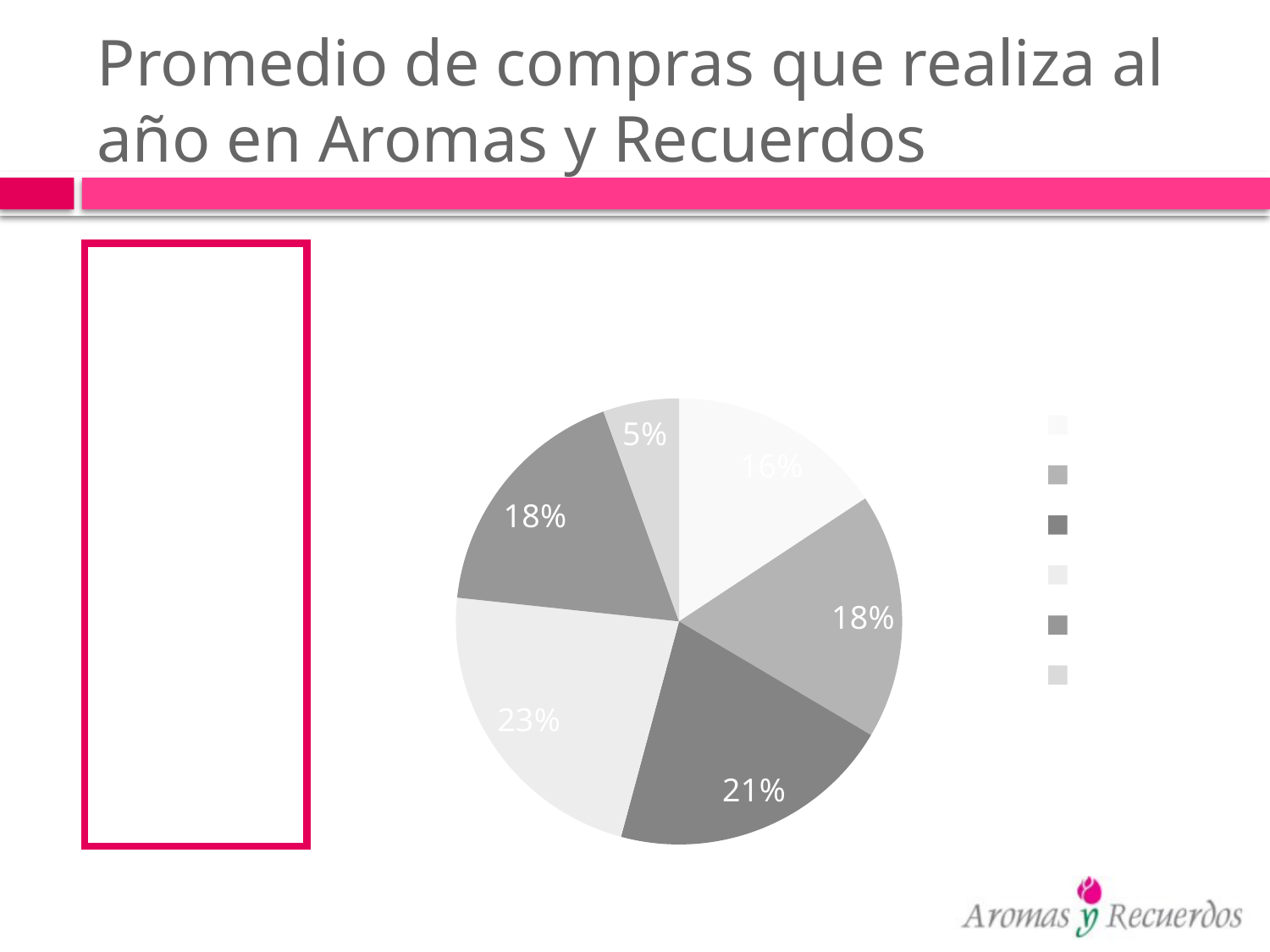
What is the percentage of the smallest slice in the pie chart? 5% What kind of chart is shown on the slide? pie chart What is the percentage of the largest slice in the pie chart? 23% What is the difference between the largest slice (23%) and the smallest slice (5%) in the pie chart? 18% How many slices does the pie chart have? 6 How many slices in the pie chart are labeled 18%? 2 How many entries does the legend of the pie chart show? 6 What is the title of the slide containing the pie chart? Promedio de compras que realiza al año en Aromas y Recuerdos Is the largest slice of the pie chart greater or less than 20%? greater Which is larger, the slice labeled 21% or the slice labeled 16%? the slice labeled 21%